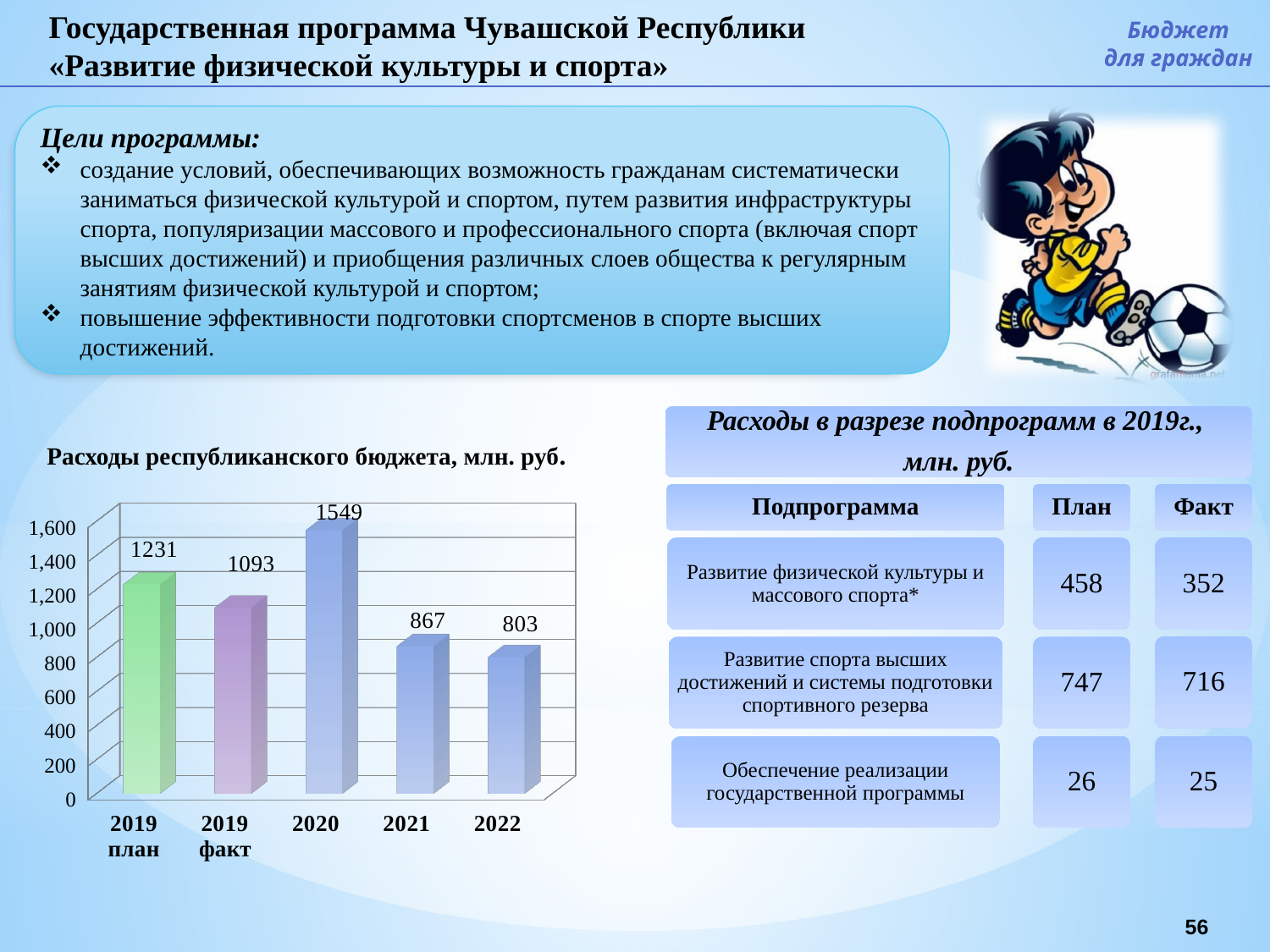
What is the value for '2019 факт' in the chart? 1093 Which category has the highest value in the chart? 2020 What kind of chart is shown on the slide? bar chart What is the value for '2019 план' in the chart? 1231 What is the difference between the values for 2021 and 2022? 64 How many bars are shown in the chart? 5 Which category has the lowest value in the chart? 2022 What is the value for 2020 in the chart 'Расходы республиканского бюджета, млн. руб.'? 1549 What is the difference between the values for '2019 план' and '2019 факт'? 138 What is the value for 2022 in the chart? 803 Is the value for 2021 greater or less than 1,000? less Which is larger, the value for 2020 or the value for 2021? 2020